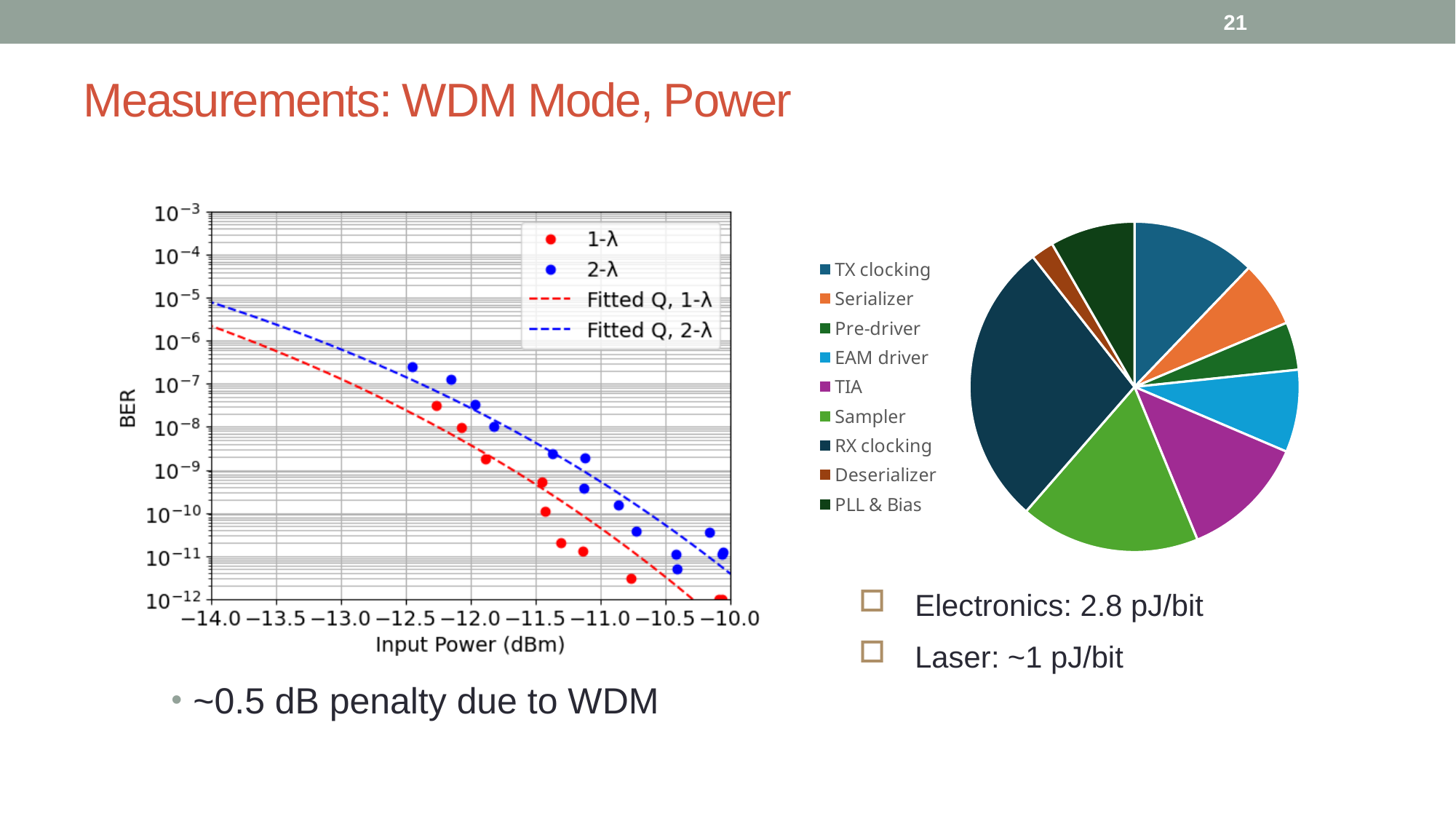
In the left chart, how many entries does the legend list? 4 In the left chart, is the 1-λ BER at -12.0 dBm greater or less than 10^-9? greater In the pie chart, which slice is larger, Sampler or TIA? Sampler In the pie chart, which category has the smallest slice? Deserializer What kind of chart is the chart on the right of the slide? Pie chart In the pie chart, how many categories does the legend list? 9 In the pie chart, which slice is larger, TX clocking or Serializer? TX clocking In the left chart, does BER rise or fall as input power increases? Fall In the pie chart, which category has the largest slice? RX clocking In the left chart, at the same input power, which series has the higher BER, 1-λ or 2-λ? 2-λ What kind of chart is the chart on the left of the slide? Scatter plot with fitted lines In the left chart, what is the label of the x axis? Input Power (dBm)